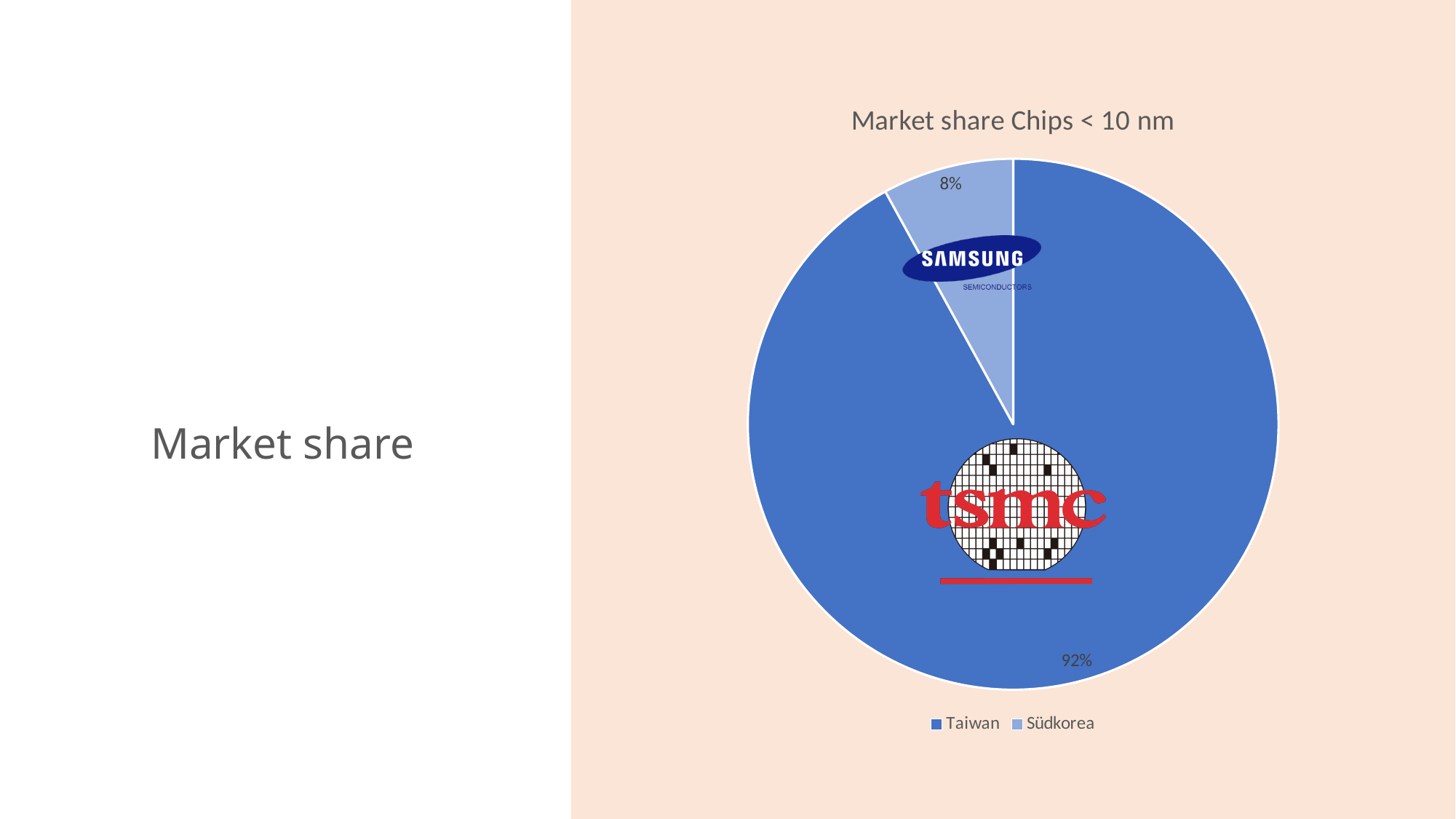
Which company logo is placed on the Südkorea slice? Samsung What is the market share for Taiwan? 92% What type of chart is shown on the slide? pie chart How many entries does the legend list? 2 Which category has the largest share of the pie? Taiwan What is the chart's title? Market share Chips < 10 nm Which category has the smallest share of the pie? Südkorea What is the market share for Südkorea? 8% Which is larger, the share for Taiwan or the share for Südkorea? Taiwan What is the difference in percentage points between Taiwan's and Südkorea's shares? 84 How many slices does the pie chart have? 2